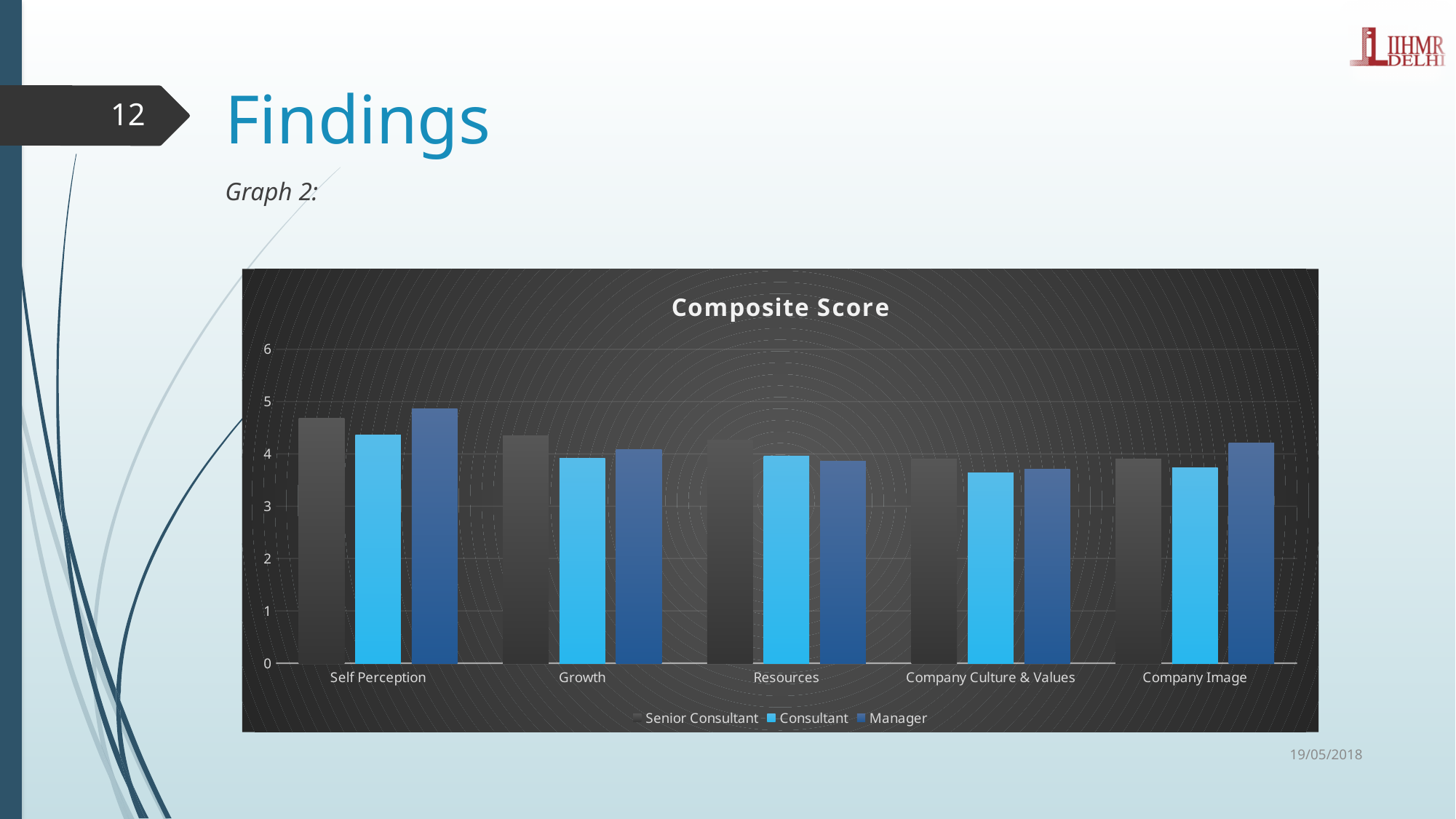
What kind of chart is shown on the slide? bar chart For which category is the Manager bar highest? Self Perception For Growth, which is larger: the Senior Consultant value or the Consultant value? Senior Consultant Is the Senior Consultant value for Self Perception greater or less than 5? less Which series are listed in the legend? Senior Consultant, Consultant, Manager For which category is the Senior Consultant bar highest? Self Perception How many series does the legend list? 3 How many categories are shown on the x axis? 5 Is the Manager value for Company Image greater or less than 4? greater Is the Consultant value for Company Culture & Values greater or less than 4? less What is the title of the chart? Composite Score